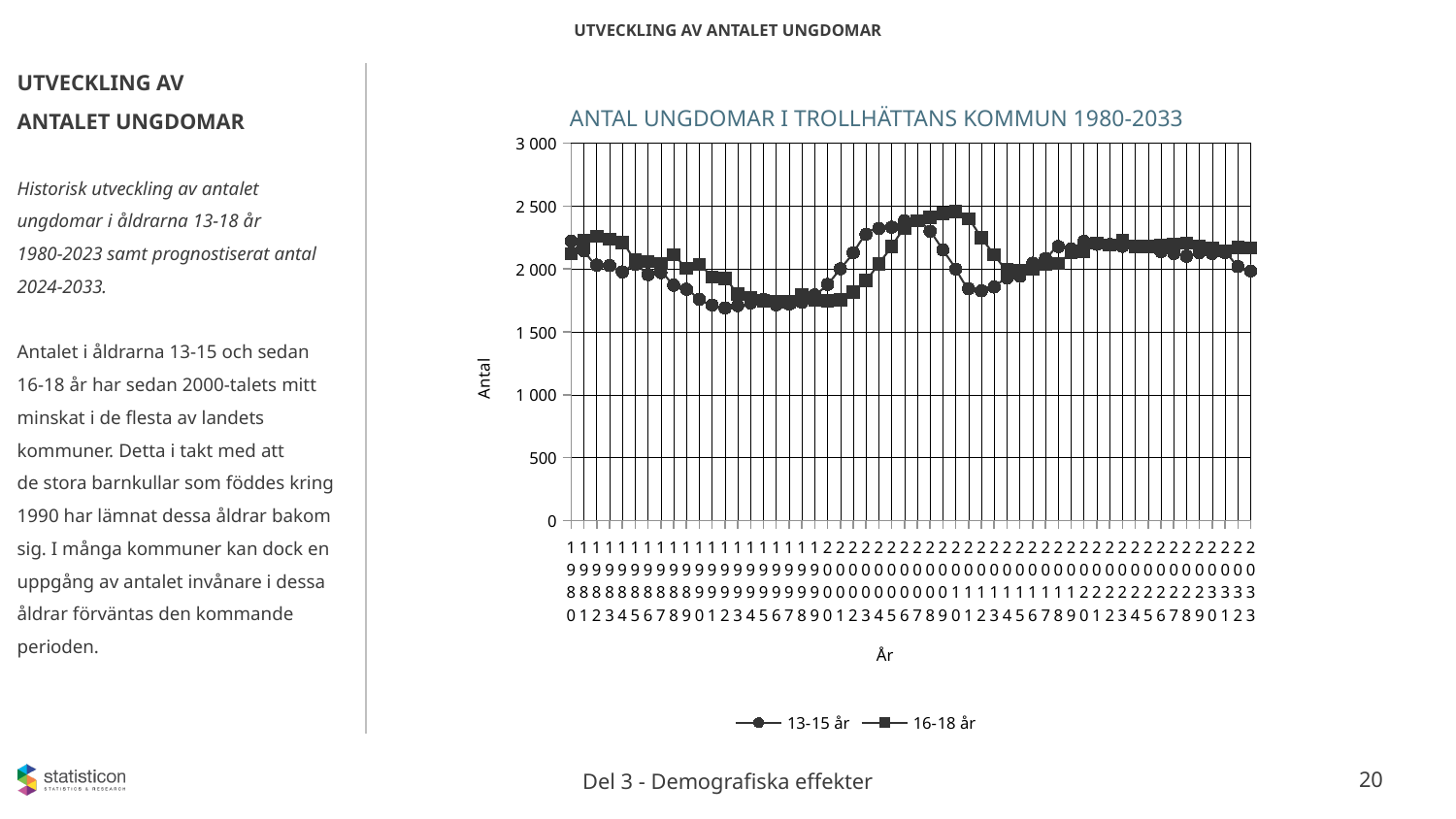
Is the value for 16-18 år in 1995 greater or less than 2 000? less Does the 13-15 år series rise or fall between 1980 and 1990? fall What kind of chart is shown on the slide? line chart How many series does the legend of the chart list? 2 What is the title of the chart? ANTAL UNGDOMAR I TROLLHÄTTANS KOMMUN 1980-2033 How many years are plotted along the x axis of the chart? 54 Which two series are listed in the chart legend? 13-15 år and 16-18 år In 2005, which series has the larger value, 13-15 år or 16-18 år? 13-15 år Is the value for 16-18 år in 2008 greater or less than 2 000? greater Is the value for 13-15 år in 1980 greater or less than 2 000? greater In 2010, which series has the larger value, 13-15 år or 16-18 år? 16-18 år